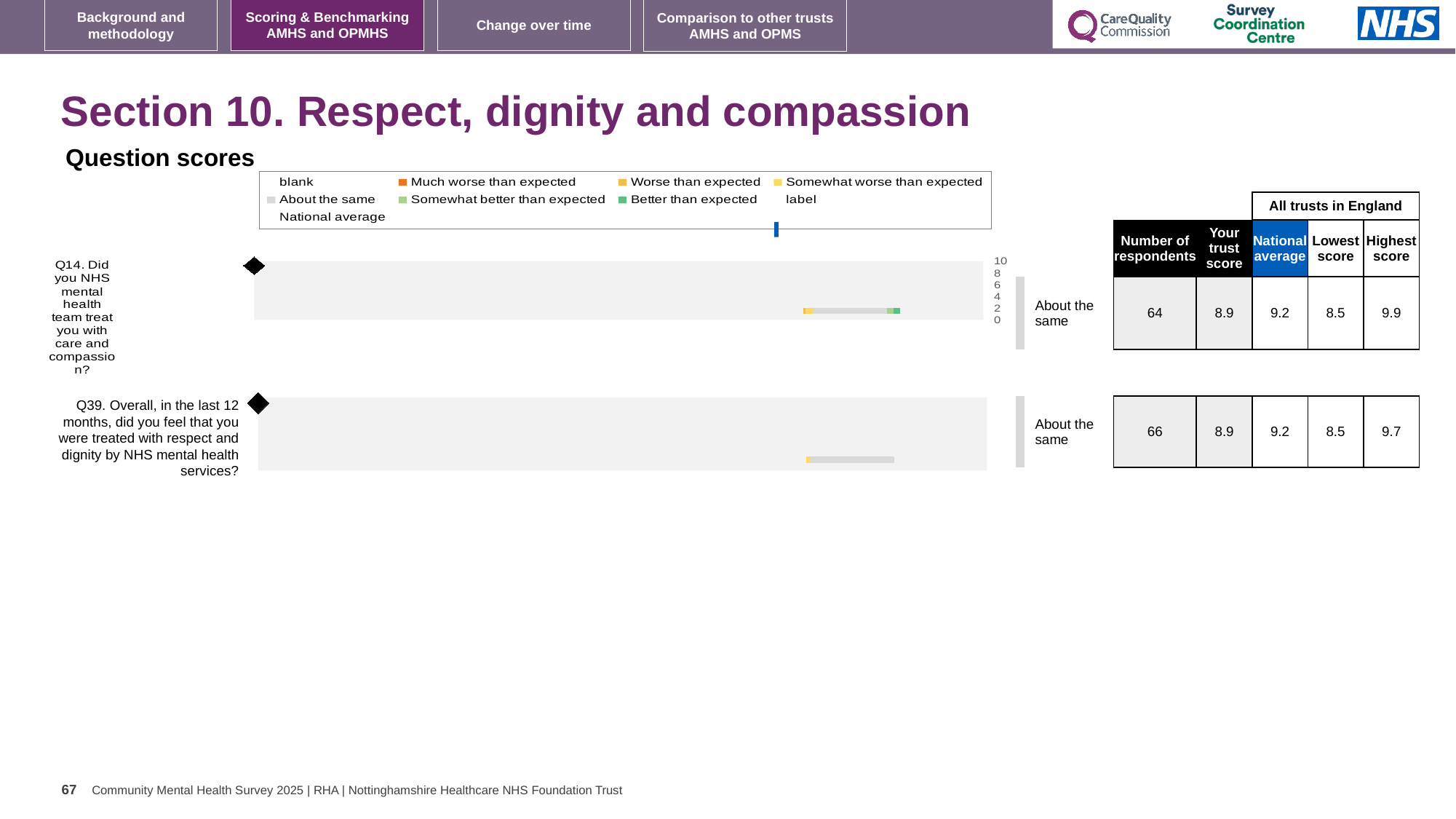
Which question has the higher 'Highest score' value, Q14 or Q39? Q14 What benchmark category is shown for Q39? About the same In the chart legend, what colour represents 'Much worse than expected'? orange What kind of chart is used to show the question scores on this slide? bar chart What is the trust score for Q14? 8.9 What is the heading printed above the chart? Question scores What is the national average for Q39? 9.2 What is the number of respondents for Q14? 64 How many survey questions are plotted in the Question scores chart? 2 What is the highest score among all trusts in England for Q39? 9.7 What is the number of respondents for Q39? 66 What is the difference between the highest score and the lowest score for Q14? 1.4